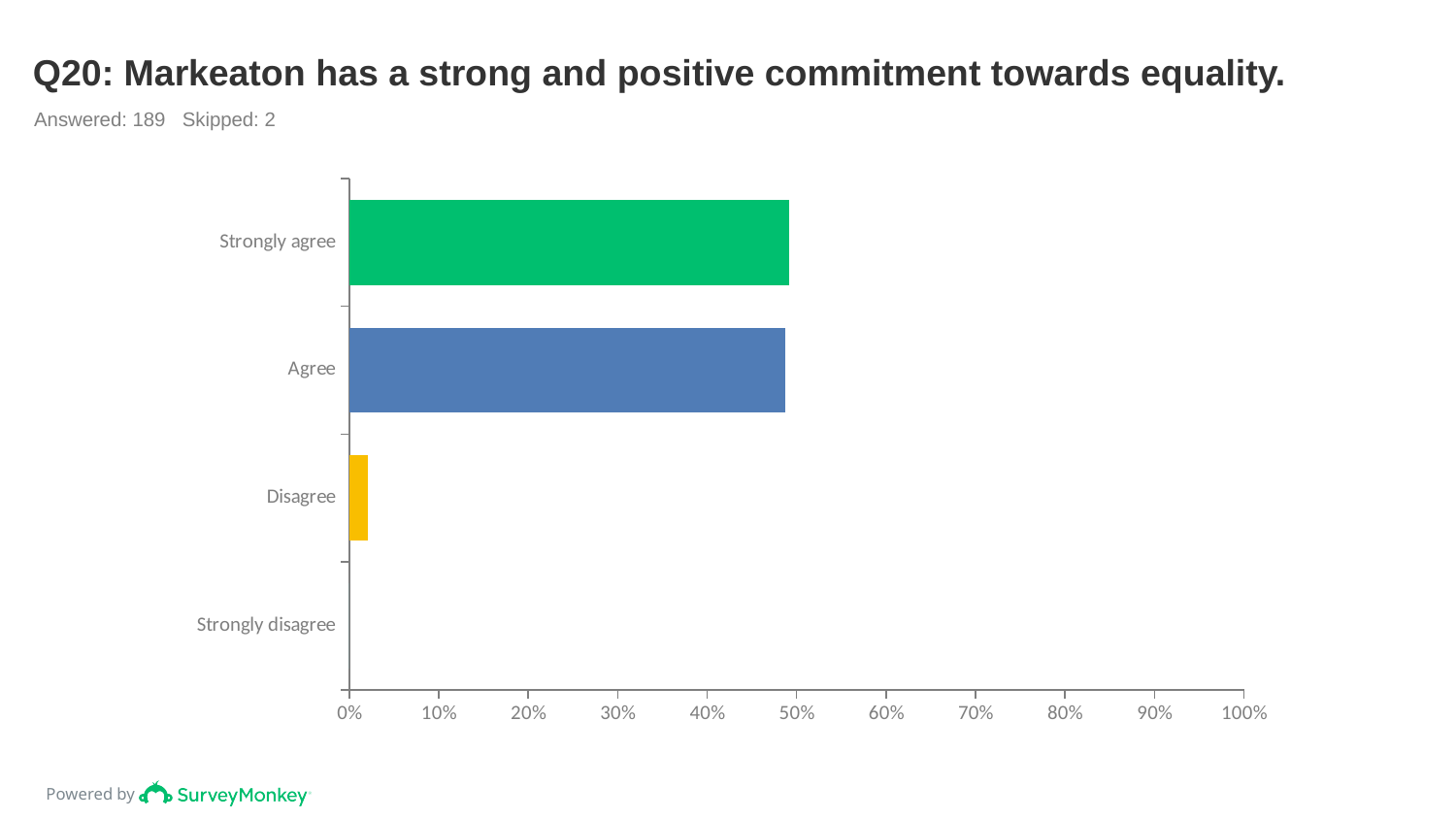
What is the highest value shown on the horizontal axis? 100% Which is larger, the value for Strongly agree or the value for Strongly disagree? Strongly agree Which response category has the lowest value? Strongly disagree How many response categories are shown on the chart? 4 Is the value for Strongly agree greater or less than 60%? less Is the value for Strongly agree greater or less than 40%? greater How many respondents answered this question according to the slide? 189 Is the value for Agree greater or less than 40%? greater What kind of chart is shown on the slide? bar chart What is the title of the chart? Q20: Markeaton has a strong and positive commitment towards equality. Which is larger, the value for Agree or the value for Disagree? Agree